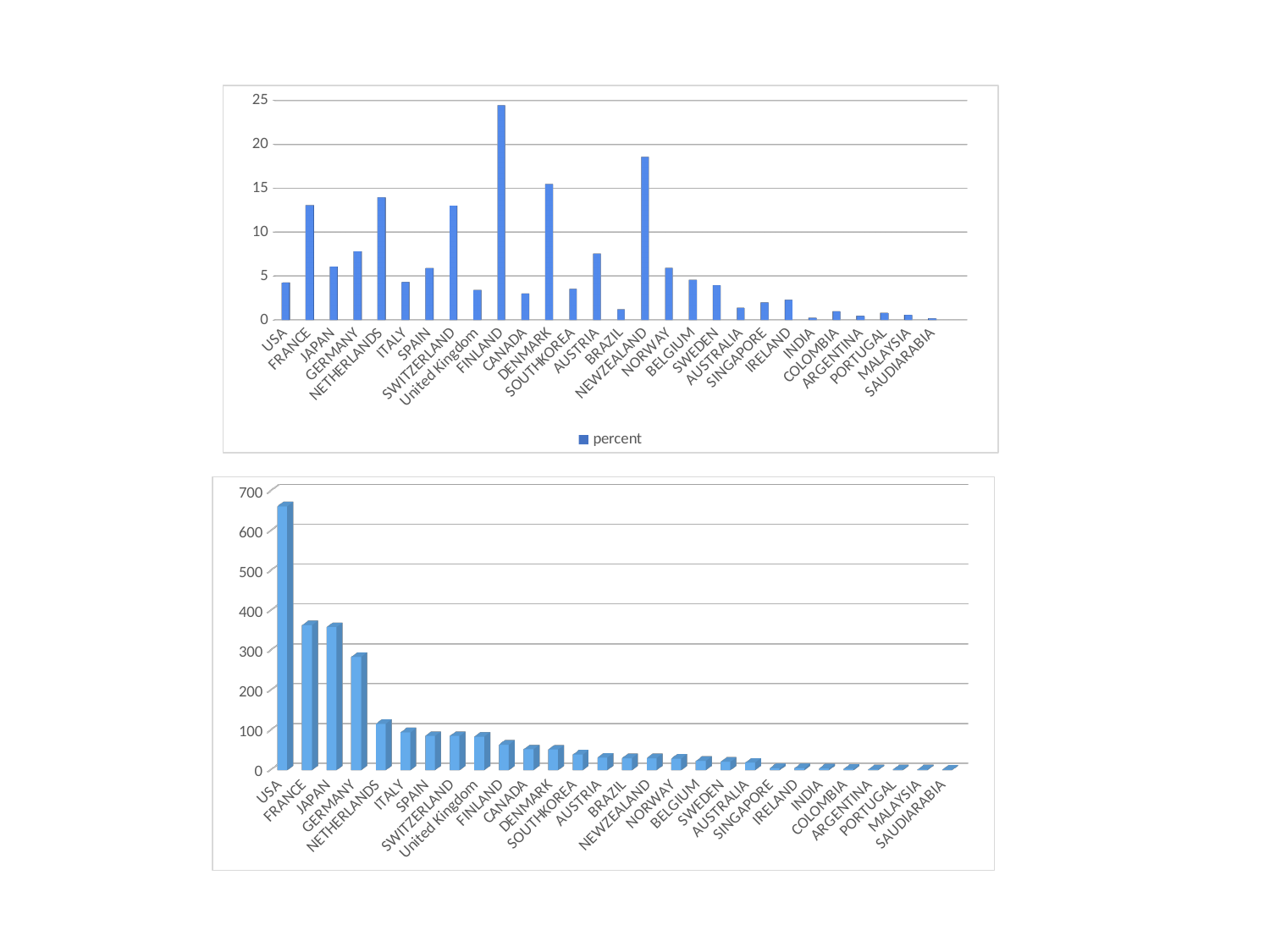
In the top chart, is the value for USA greater or less than 5? less In the top chart, is the value for FRANCE greater or less than 10? greater In the bottom chart, which is larger, the value for FRANCE or the value for GERMANY? FRANCE In the bottom chart, do the values generally rise or fall from left to right along the x axis? fall In the top chart, which is larger, the value for FINLAND or the value for NEWZEALAND? FINLAND In the top chart, is the value for NEWZEALAND greater or less than 15? greater In the top chart, which country has the highest value? FINLAND In the bottom chart, which country has the highest value? USA In the top chart, what is the name of the series shown in the legend? percent In the top chart, how many series does the legend list? 1